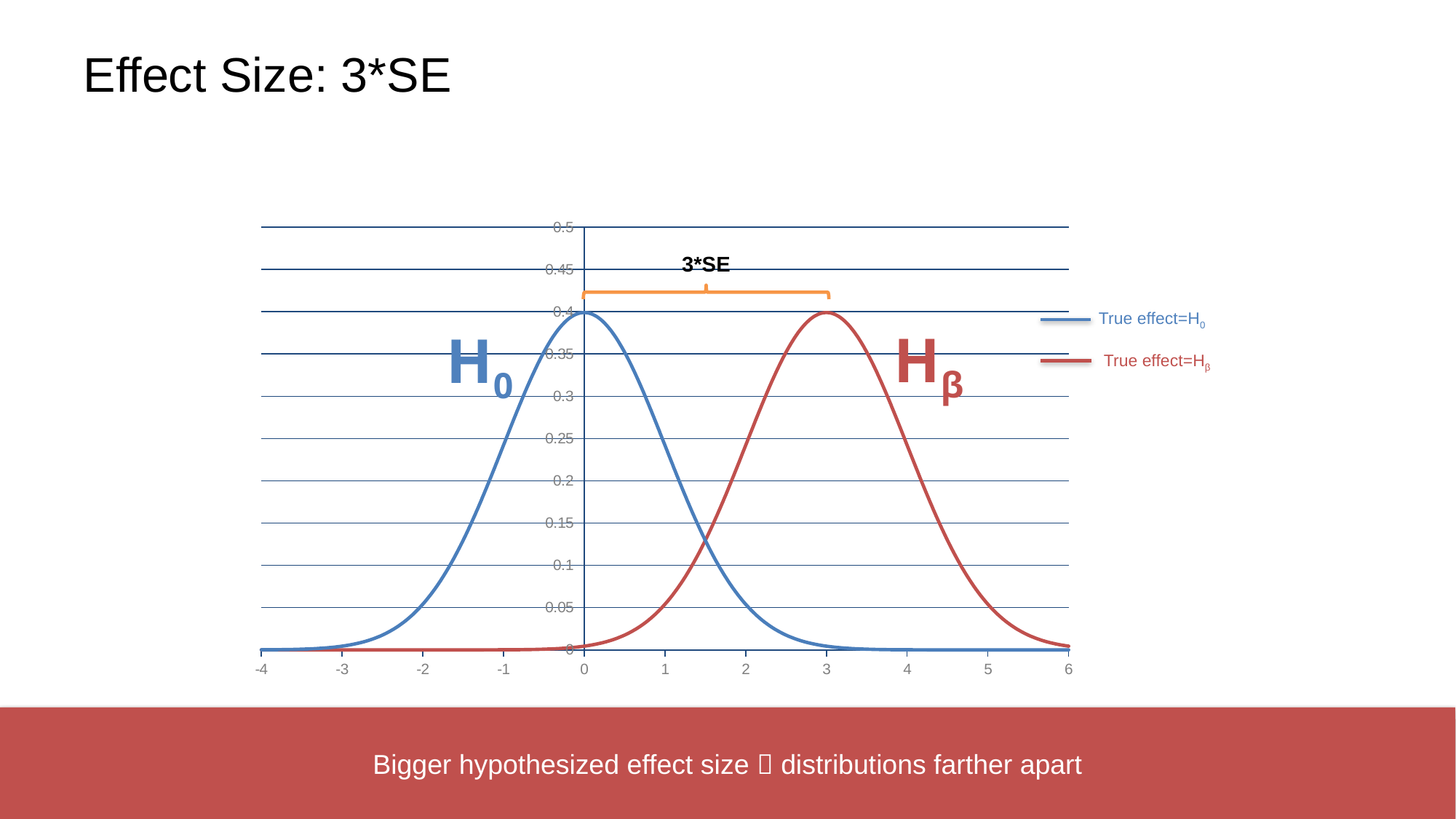
Is the peak value of the blue H0 curve greater or less than 0.35? greater What colour is the curve labelled True effect=Hβ? Red Does the red Hβ curve rise or fall as x increases from 3 to 6? Fall What kind of chart is shown on the slide? Line chart How many tick labels are shown on the x axis of the chart? 11 Is the peak value of the red Hβ curve greater or less than 0.45? less At x = 4, which curve has the higher value, the blue H0 curve or the red Hβ curve? The red Hβ curve At which x-axis value does the red Hβ curve reach its peak? 3 At x = 1, which curve has the higher value, the blue H0 curve or the red Hβ curve? The blue H0 curve At which x-axis value does the blue H0 curve reach its peak? 0 How many series does the chart legend list? 2 What are the two legend entries of the chart? True effect=H0 and True effect=Hβ